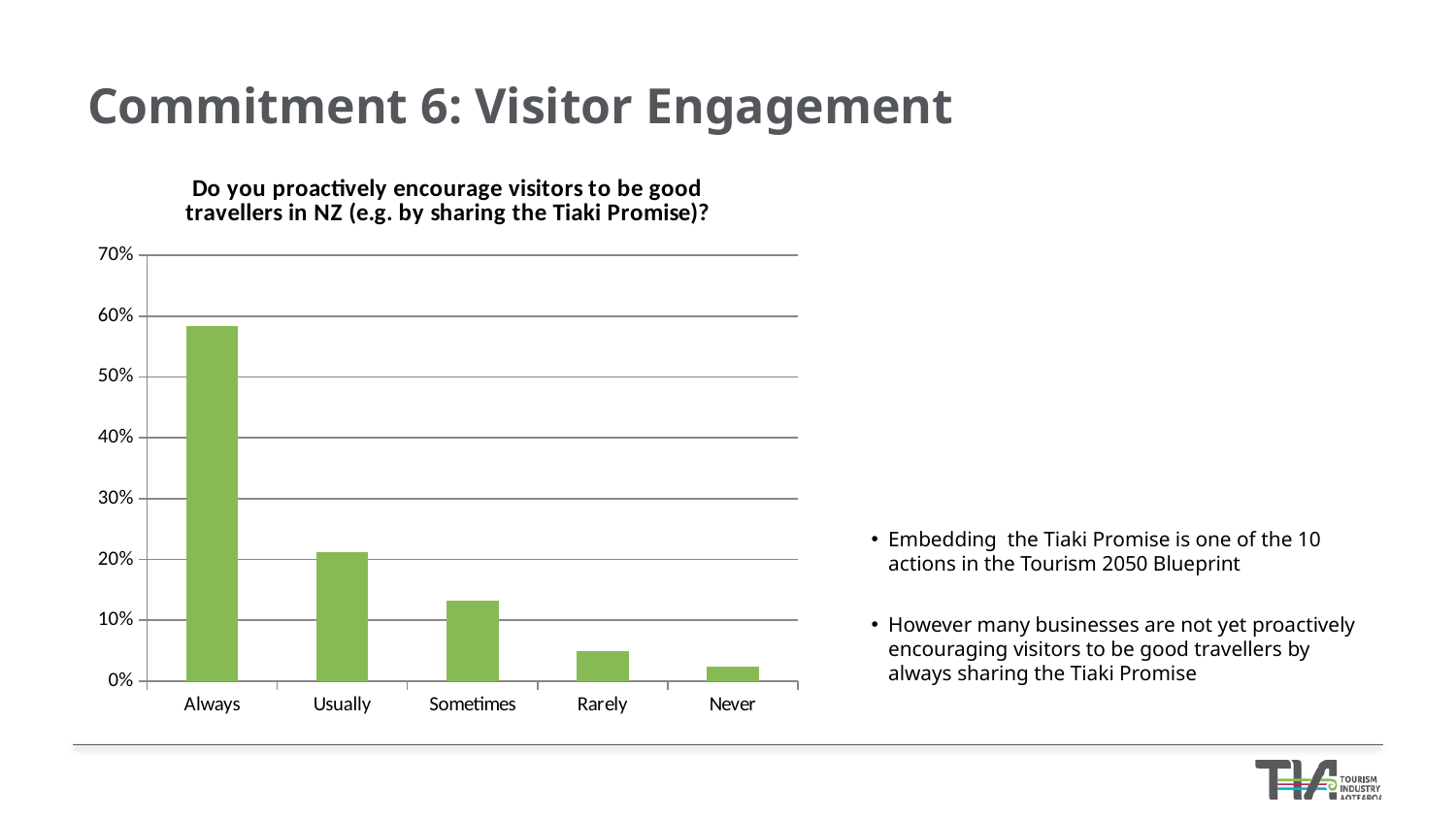
Which response category has the highest value? Always Is the value for Usually greater or less than 20%? greater Is the value for Always greater or less than 60%? less Which is larger, the value for Usually or the value for Sometimes? Usually Which response category has the lowest value? Never Is the value for Always greater or less than 50%? greater What is the title of the chart? Do you proactively encourage visitors to be good travellers in NZ (e.g. by sharing the Tiaki Promise)? Do the values rise or fall moving from Always to Never along the x axis? fall How many response categories are shown on the x axis? 5 What kind of chart is shown on the slide? bar chart